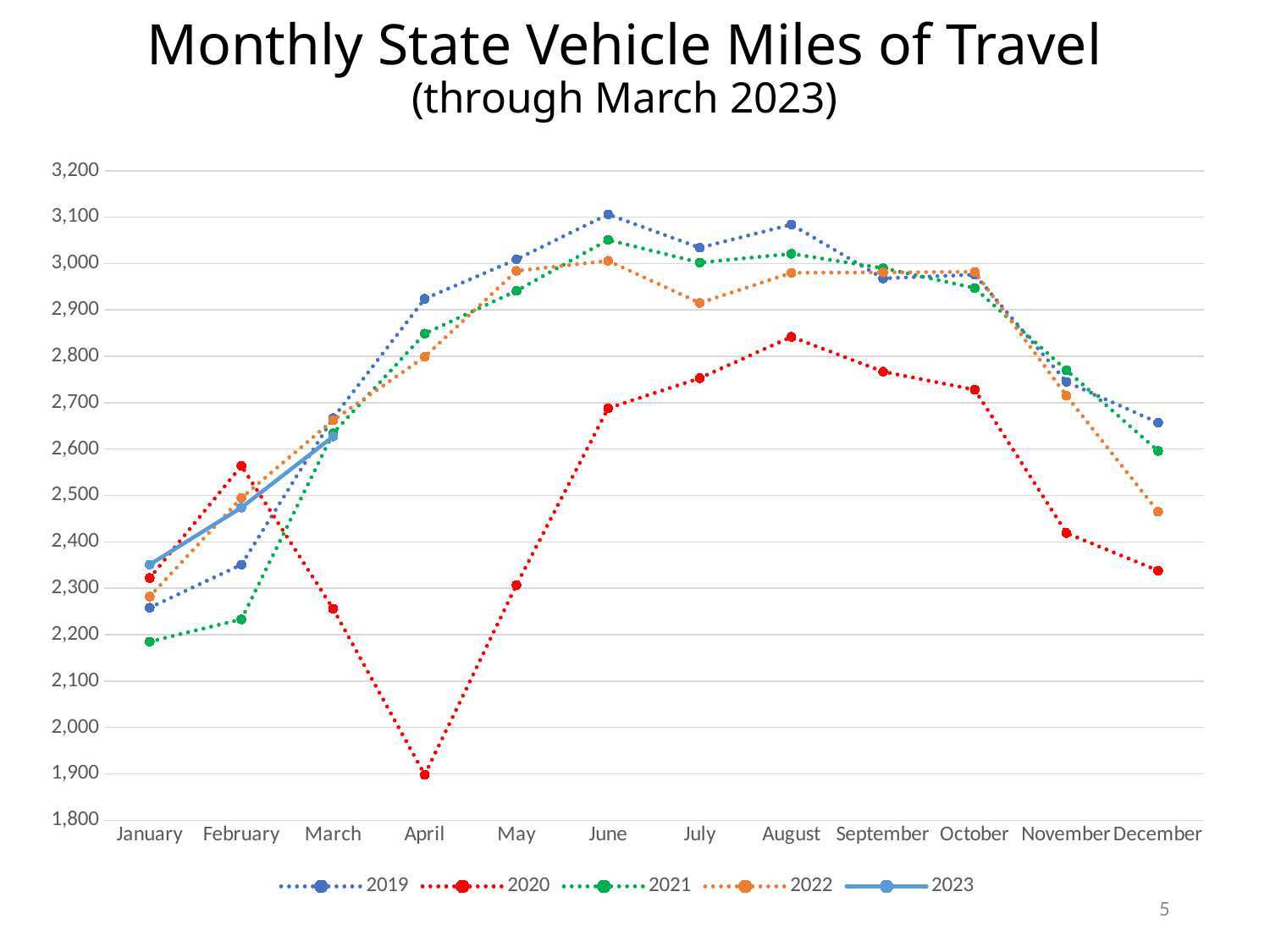
In which month does the 2020 series reach its lowest value? April Is the value for 2020 in April greater or less than 2,000? less Is the value for 2019 in June greater or less than 3,000? greater How many months are shown along the x axis? 12 Which series is drawn as a solid line rather than a dotted line? 2023 In April, which series has the larger value, 2019 or 2020? 2019 Does the 2023 series rise or fall from January to March? rise Is the value for 2022 in December greater or less than 2,500? less In which month does the 2019 series reach its highest value? June What kind of chart is shown on the slide? line chart In which month does the 2021 series have its lowest value? January How many series does the legend list? 5